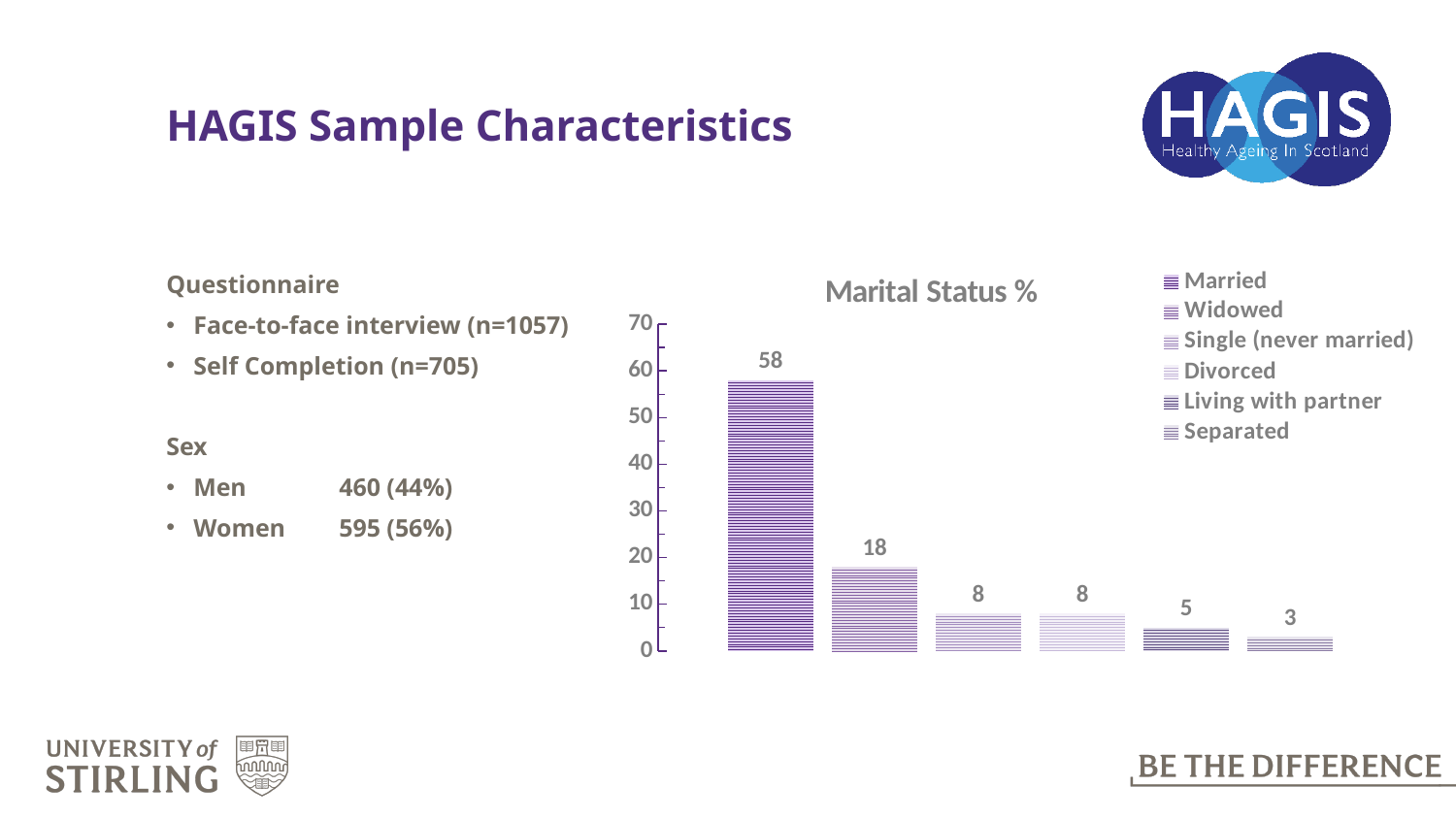
Which marital status category has the highest value in the chart? Married How many entries does the legend of the Marital Status % chart list? 6 Which is larger in the Marital Status % chart, Widowed or Living with partner? Widowed What is the value for Widowed in the Marital Status % chart? 18 What is the value for Married in the Marital Status % chart? 58 Do the bar values in the Marital Status % chart rise or fall from left to right? fall What is the value for Living with partner in the Marital Status % chart? 5 What is the difference between the values for Married and Widowed in the Marital Status % chart? 40 Which marital status category has the lowest value in the chart? Separated How many bars are plotted in the Marital Status % chart? 6 What is the value for Separated in the Marital Status % chart? 3 What type of chart is shown under the title 'Marital Status %'? bar chart